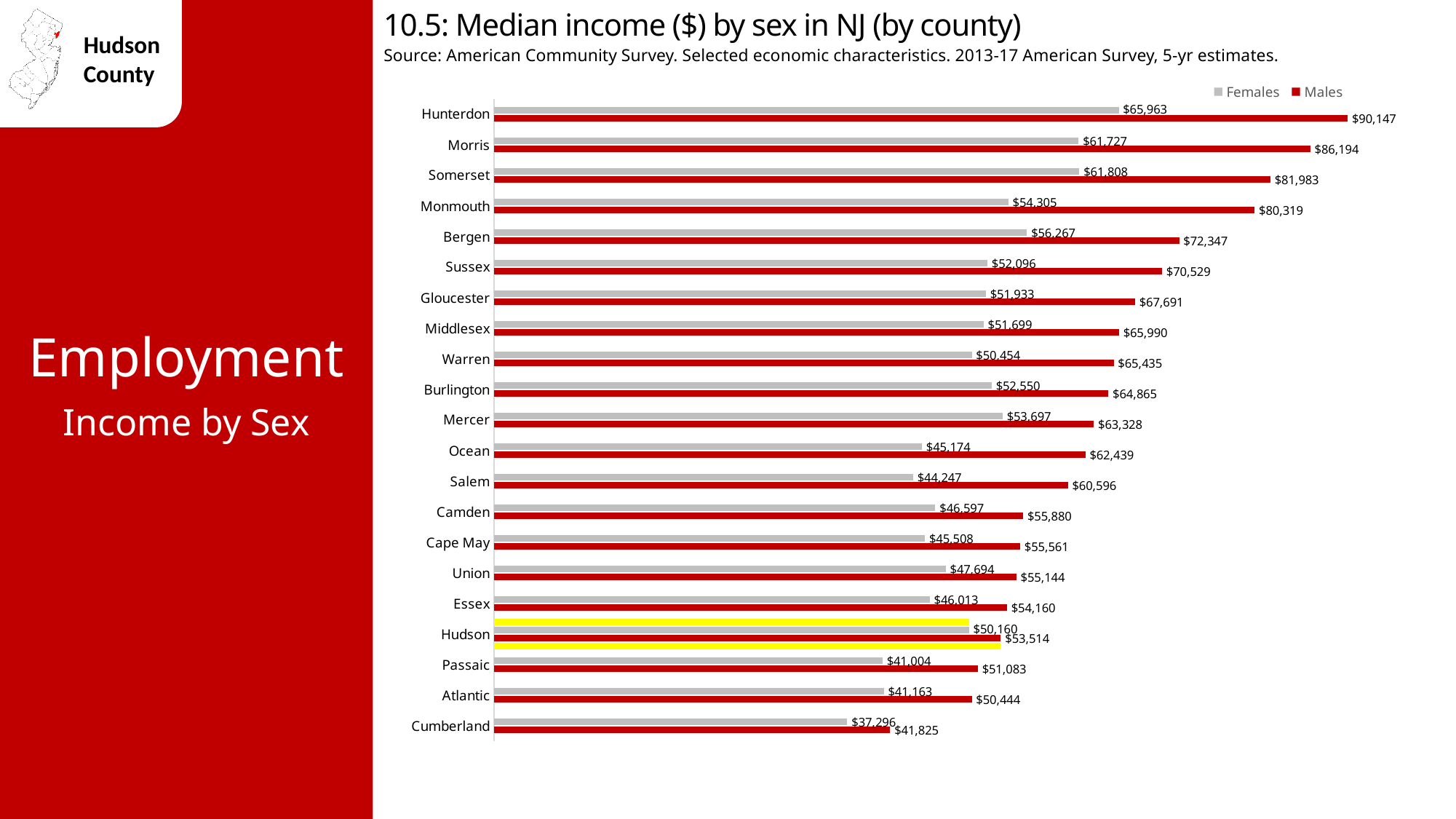
What is the difference between male median income in Hunterdon and in Morris? $3,953 What is the median income for females in Hunterdon County? $65,963 Which county's bars are highlighted in yellow? Hudson What kind of chart is shown on the slide? Bar chart What is the difference between male and female median income in Hudson County? $3,354 Which county has the lowest median income for females? Cumberland What is the median income for males in Hudson County? $53,514 How many series does the legend list? 2 Which is larger: the female median income in Bergen or in Monmouth? Bergen What is the median income for females in Cumberland County? $37,296 How many counties are shown in the chart? 21 Which county has the highest median income for males? Hunterdon